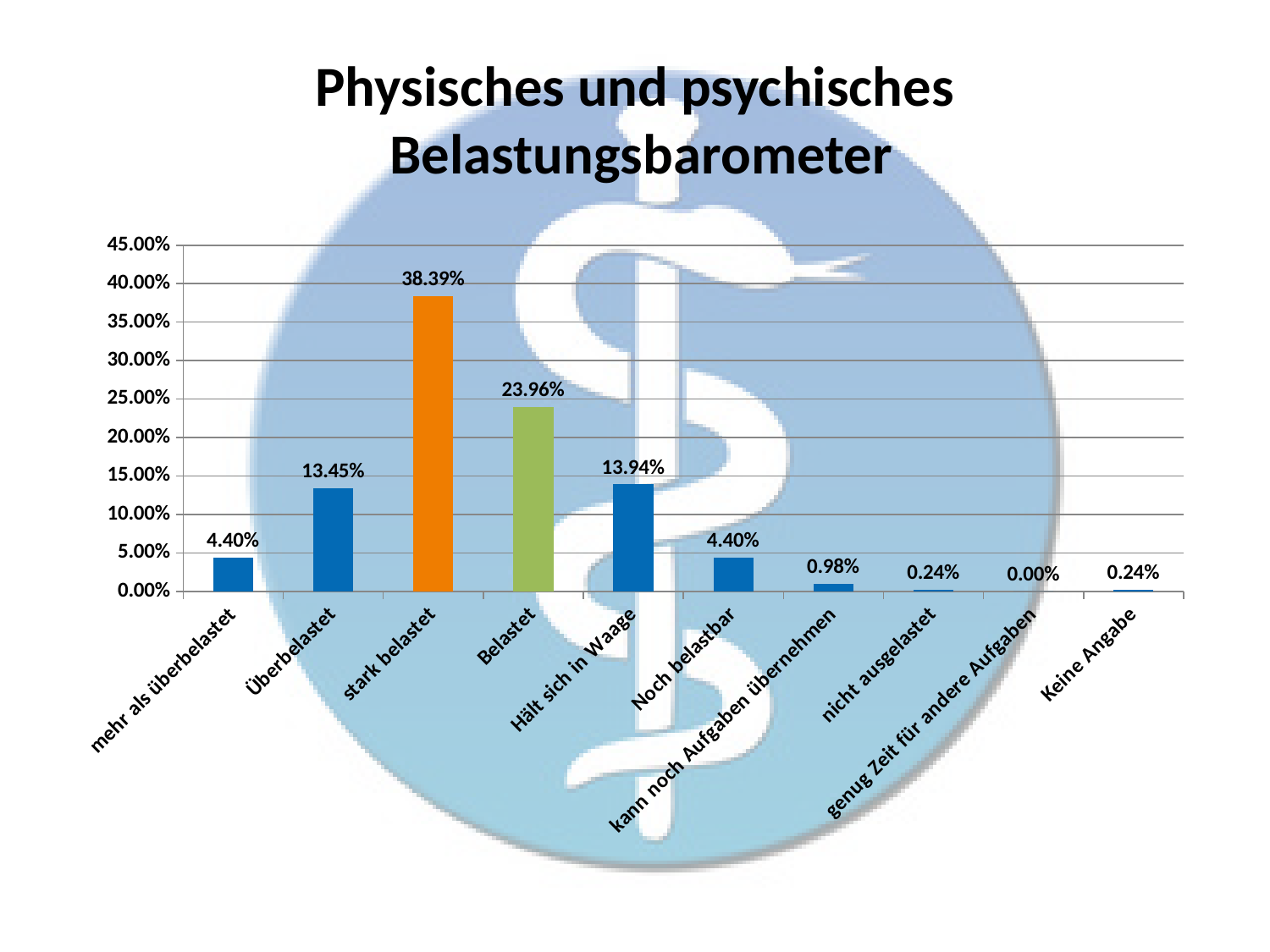
What is the difference between the values for "stark belastet" and "Belastet"? 14.43% What is the value for "stark belastet"? 38.39% What is the value for "kann noch Aufgaben übernehmen"? 0.98% What kind of chart is shown on the slide? bar chart Which is larger, the value for "Überbelastet" or the value for "Hält sich in Waage"? Hält sich in Waage Which category has the highest value? stark belastet Is the value for "Belastet" greater or less than 20.00%? greater What is the value for "Hält sich in Waage"? 13.94% Which category has the lowest value? genug Zeit für andere Aufgaben What is the title of the chart? Physisches und psychisches Belastungsbarometer What is the value for "Belastet"? 23.96% How many categories are shown on the x axis? 10